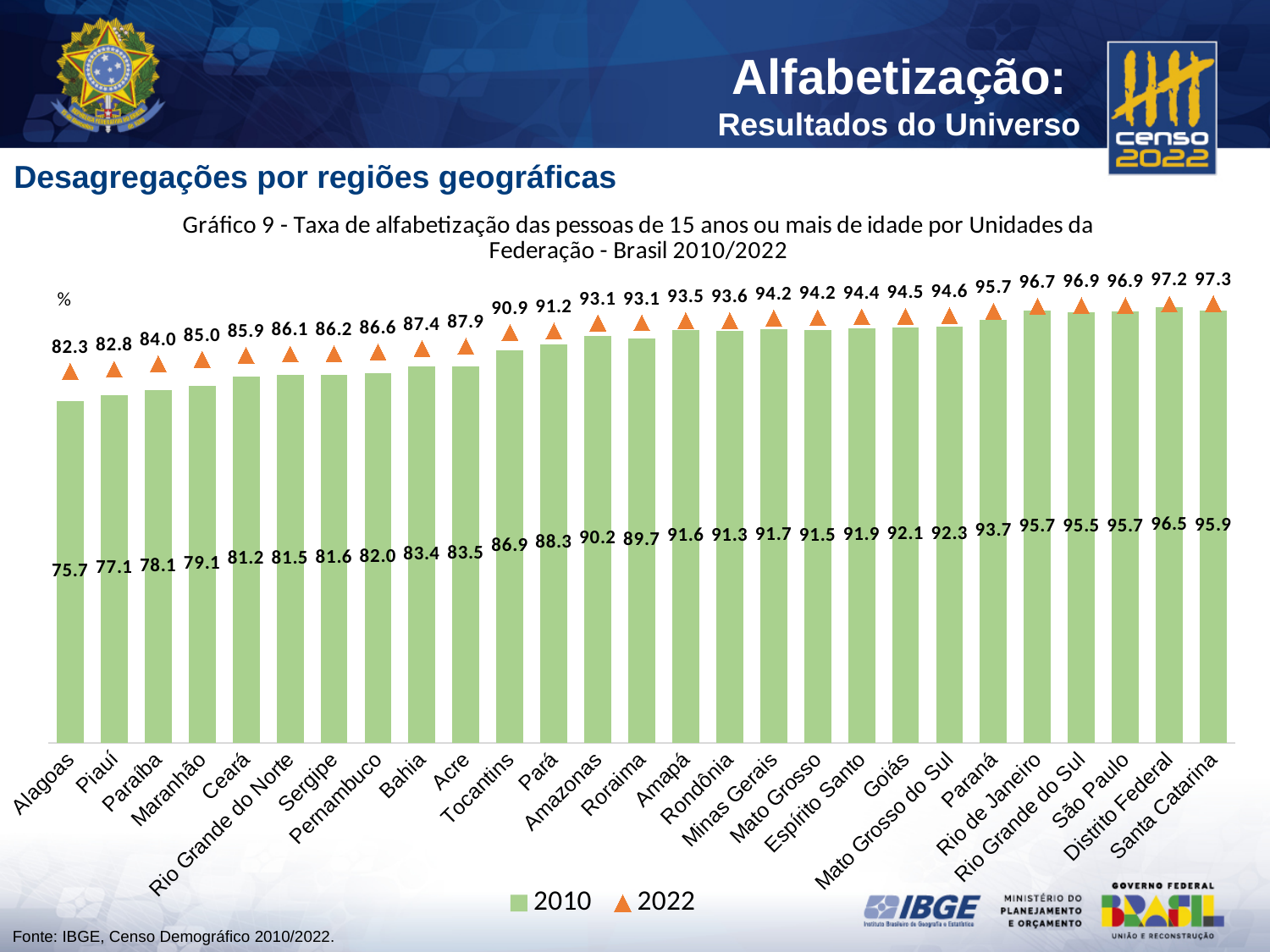
What is the difference between the 2022 and 2010 literacy rates for Santa Catarina? 1.4 What kind of chart is used to show the 2010 values? bar chart How many series does the legend list? 2 How many federation units are shown on the chart? 27 What is the 2010 literacy rate for Santa Catarina? 95.9 Which state has the highest 2010 literacy rate? Distrito Federal Which had a higher 2010 literacy rate, Pará or Roraima? Roraima Which state has the highest 2022 literacy rate? Santa Catarina By how many percentage points did the literacy rate in Alagoas increase from 2010 to 2022? 6.6 Which state has the lowest 2010 literacy rate? Alagoas What is the 2022 literacy rate for Alagoas? 82.3 What is the 2022 literacy rate for Distrito Federal? 97.2